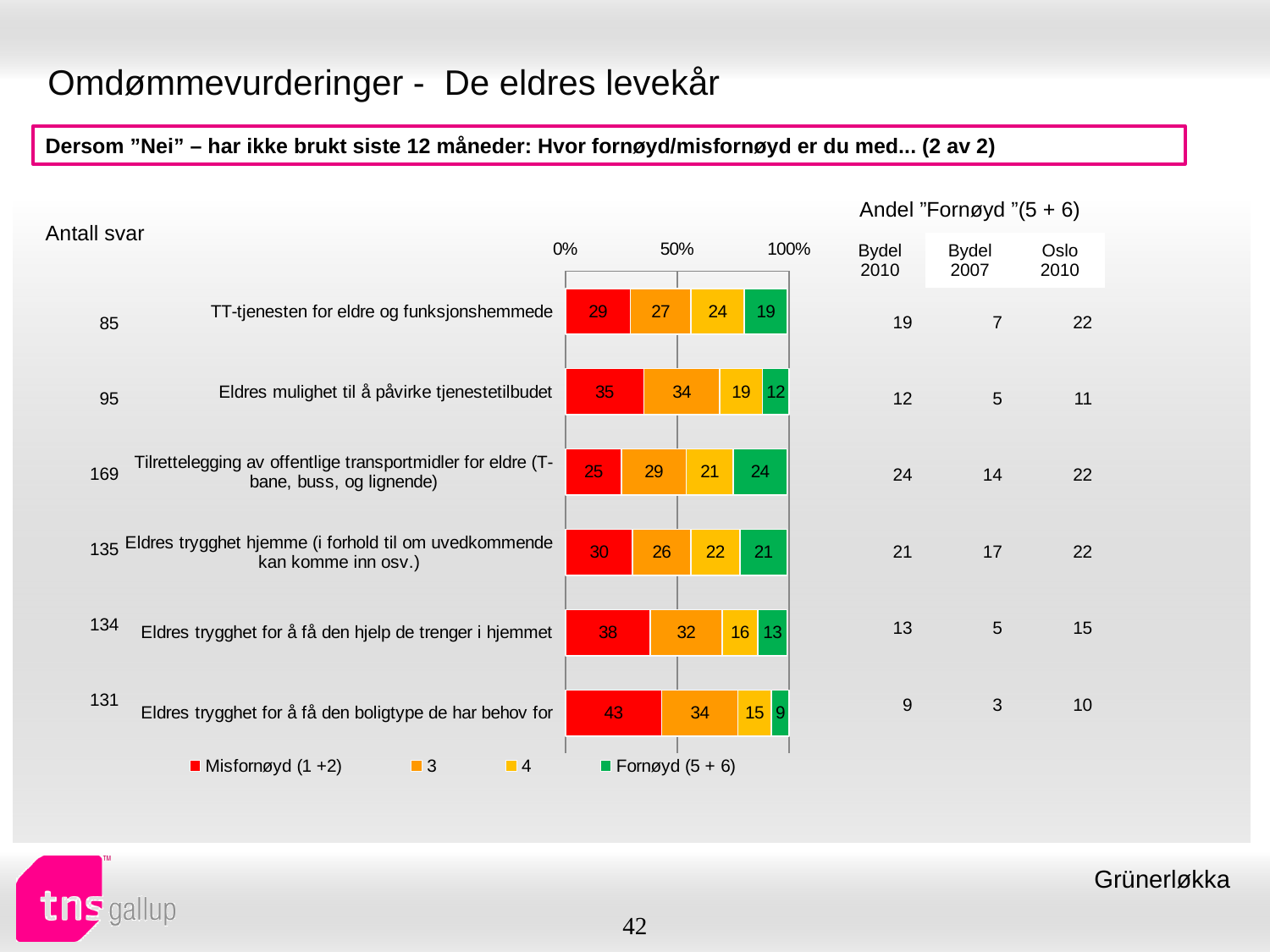
What is the value of "Fornøyd (5 + 6)" for "Tilrettelegging av offentlige transportmidler for eldre (T-bane, buss, og lignende)"? 24 What kind of chart is shown on the slide? Stacked bar chart What is the value of "Misfornøyd (1 +2)" for "Eldres trygghet for å få den boligtype de har behov for"? 43 What is the difference between the "Misfornøyd (1 +2)" values for "Eldres trygghet for å få den hjelp de trenger i hjemmet" and "TT-tjenesten for eldre og funksjonshemmede"? 9 Which category has the lowest "Fornøyd (5 + 6)" value? Eldres trygghet for å få den boligtype de har behov for How many series does the legend list? 4 What is the value of series "4" for "Eldres trygghet hjemme (i forhold til om uvedkommende kan komme inn osv.)"? 22 What is the value of series "3" for "Eldres trygghet for å få den hjelp de trenger i hjemmet"? 32 Which is larger: the "Fornøyd (5 + 6)" value for "TT-tjenesten for eldre og funksjonshemmede" or for "Eldres mulighet til å påvirke tjenestetilbudet"? TT-tjenesten for eldre og funksjonshemmede What colour represents "Fornøyd (5 + 6)" in the chart? Green How many categories are shown in the chart? 6 Which category has the highest "Misfornøyd (1 +2)" value? Eldres trygghet for å få den boligtype de har behov for